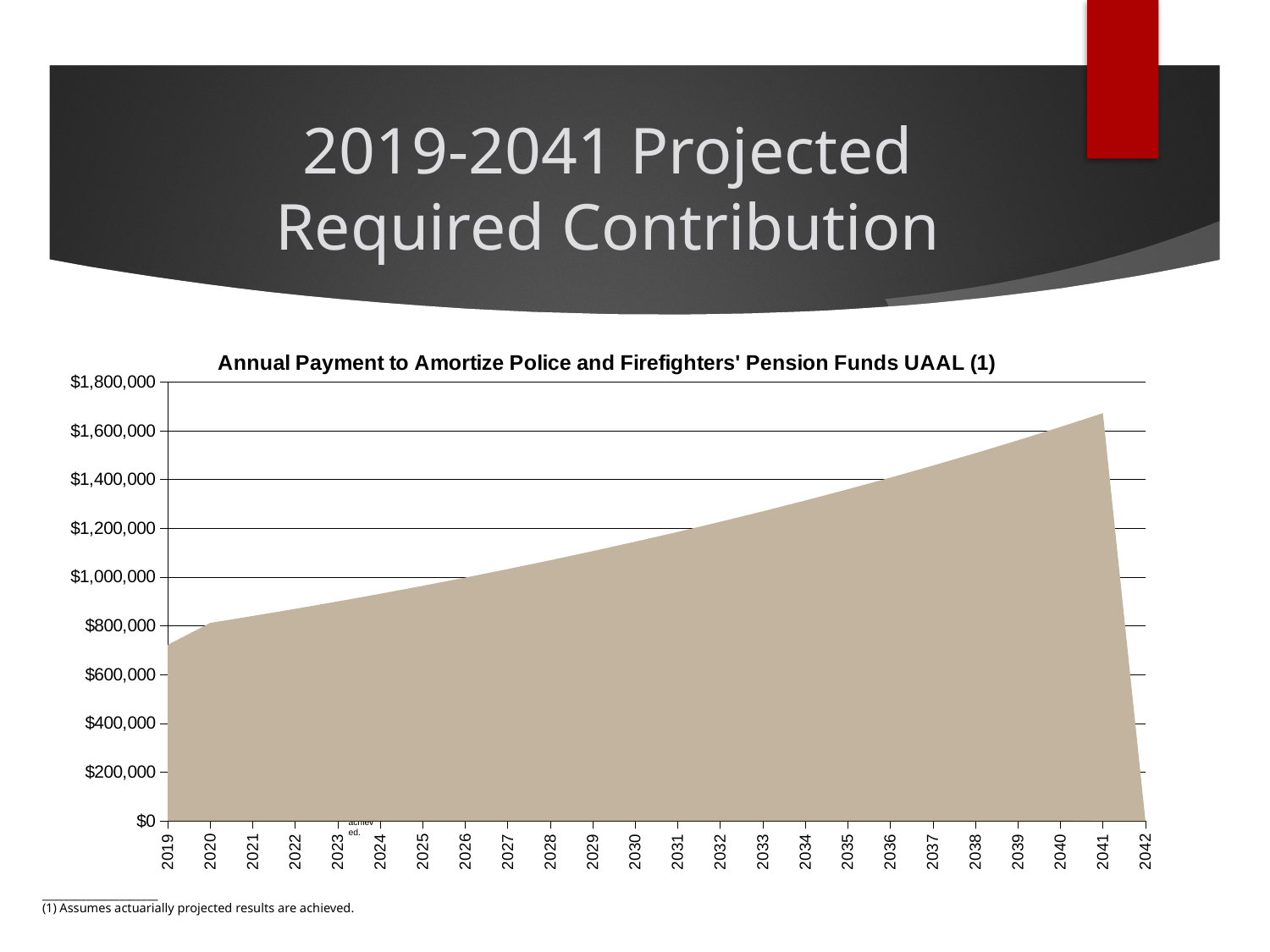
Do the annual payments rise or fall from 2019 to 2041? Rise Is the value for 2030 greater or less than $1,200,000? less Which year has the larger annual payment, 2025 or 2035? 2035 What kind of chart is shown on the slide? Area chart Which year has the highest annual payment in the chart? 2041 What is the title of the chart? Annual Payment to Amortize Police and Firefighters' Pension Funds UAAL (1) Is the value for 2041 greater or less than $1,600,000? greater How many year labels are shown on the x axis of the chart? 24 Is the value for 2038 greater or less than $1,400,000? greater What does footnote (1) on the slide say? Assumes actuarially projected results are achieved.